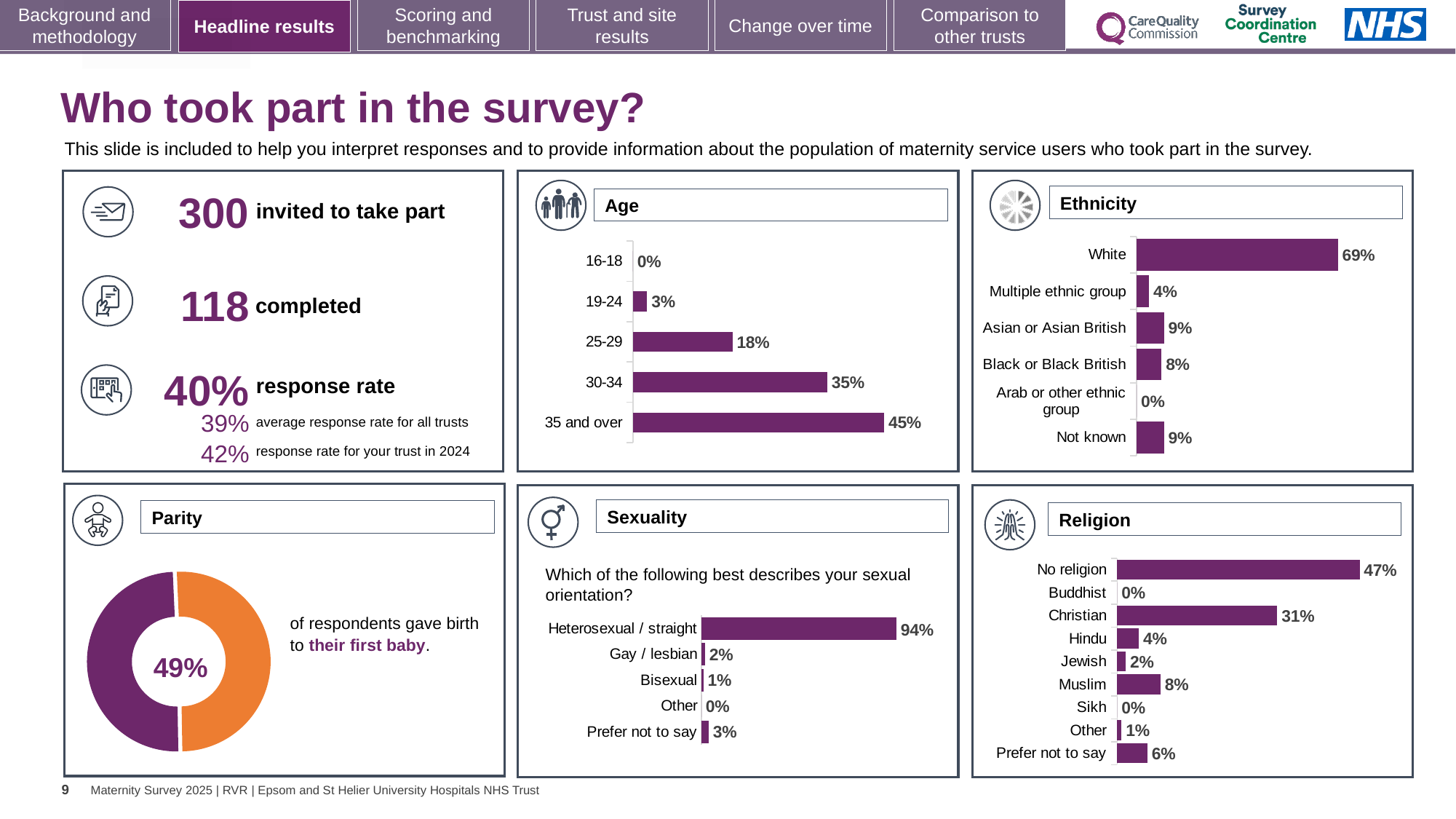
In the Age chart, which age group has the highest percentage? 35 and over In the Sexuality chart, which is larger, Gay / lesbian or Prefer not to say? Prefer not to say In the Sexuality chart, what is the value for Heterosexual / straight? 94% In the Ethnicity chart, how many ethnicity categories are shown? 6 In the Religion chart, what is the difference between No religion and Christian? 16% What kind of chart is the Parity chart? Doughnut chart In the Religion chart, what is the value for Christian? 31% In the Parity chart, what percentage of respondents gave birth to their first baby? 49% What kind of chart is the Religion chart? Bar chart In the Age chart, what percentage of respondents were aged 30-34? 35% In the Ethnicity chart, what is the difference between Asian or Asian British and Black or Black British? 1% In the Ethnicity chart, what is the value for White? 69%